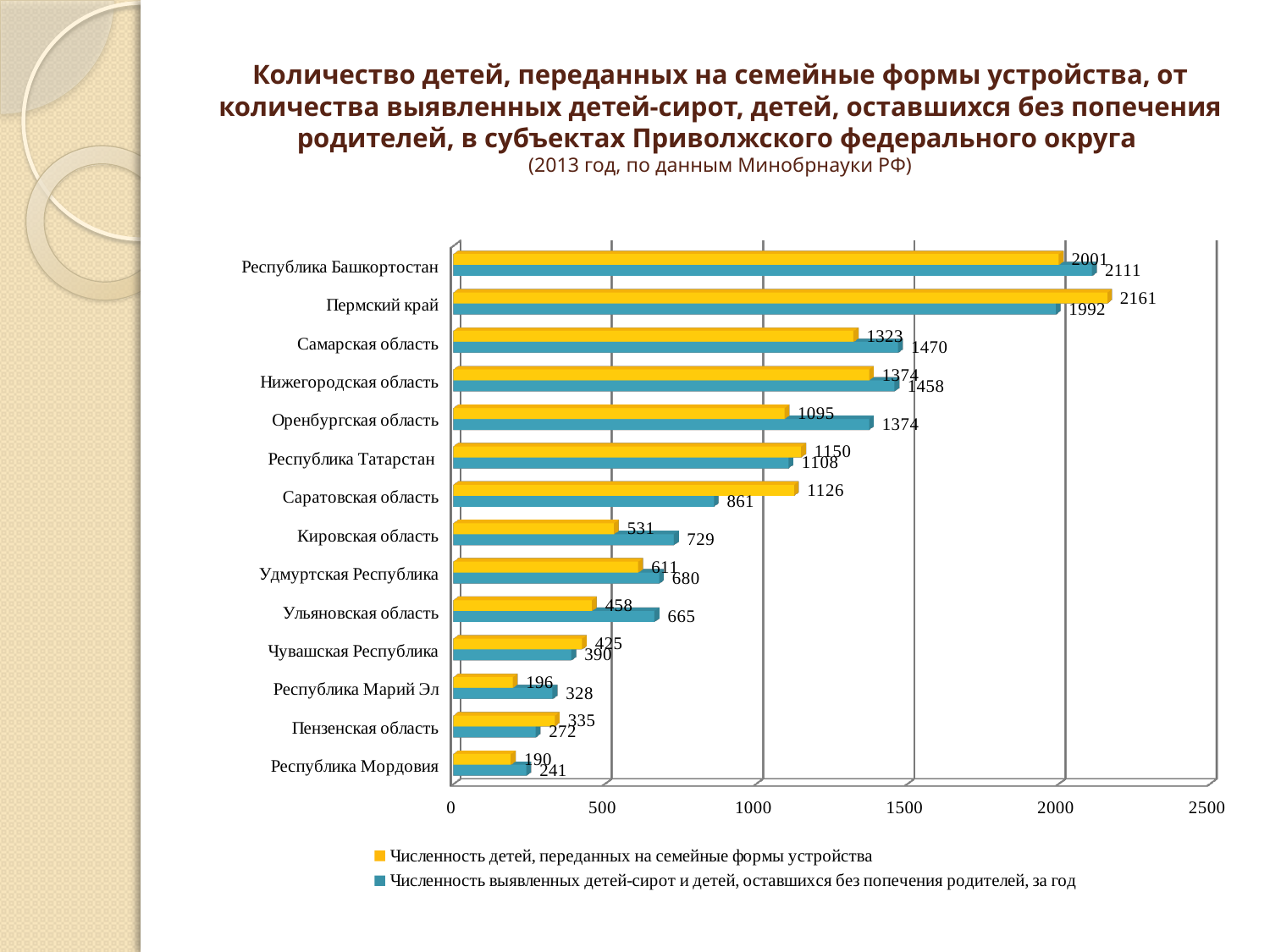
What is the value of 'Численность детей, переданных на семейные формы устройства' for Пермский край? 2161 Which region has the lowest value for 'Численность детей, переданных на семейные формы устройства'? Республика Мордовия What type of chart is shown on the slide? Bar chart What is the value of 'Численность выявленных детей-сирот и детей, оставшихся без попечения родителей, за год' for Оренбургская область? 1374 Is the value of 'Численность детей, переданных на семейные формы устройства' for Кировская область greater or less than 500? greater What is the value of 'Численность выявленных детей-сирот и детей, оставшихся без попечения родителей, за год' for Республика Башкортостан? 2111 What is the difference between the two series values for Саратовская область (1126 and 861)? 265 How many series does the legend list? 2 What colour represents 'Численность детей, переданных на семейные формы устройства' in the legend? Yellow Which region has the highest value for 'Численность детей, переданных на семейные формы устройства'? Пермский край How many regions (categories) are shown on the chart? 14 For Ульяновская область, which is larger: the number of children transferred to family forms or the number of identified orphans? Number of identified orphans (665)